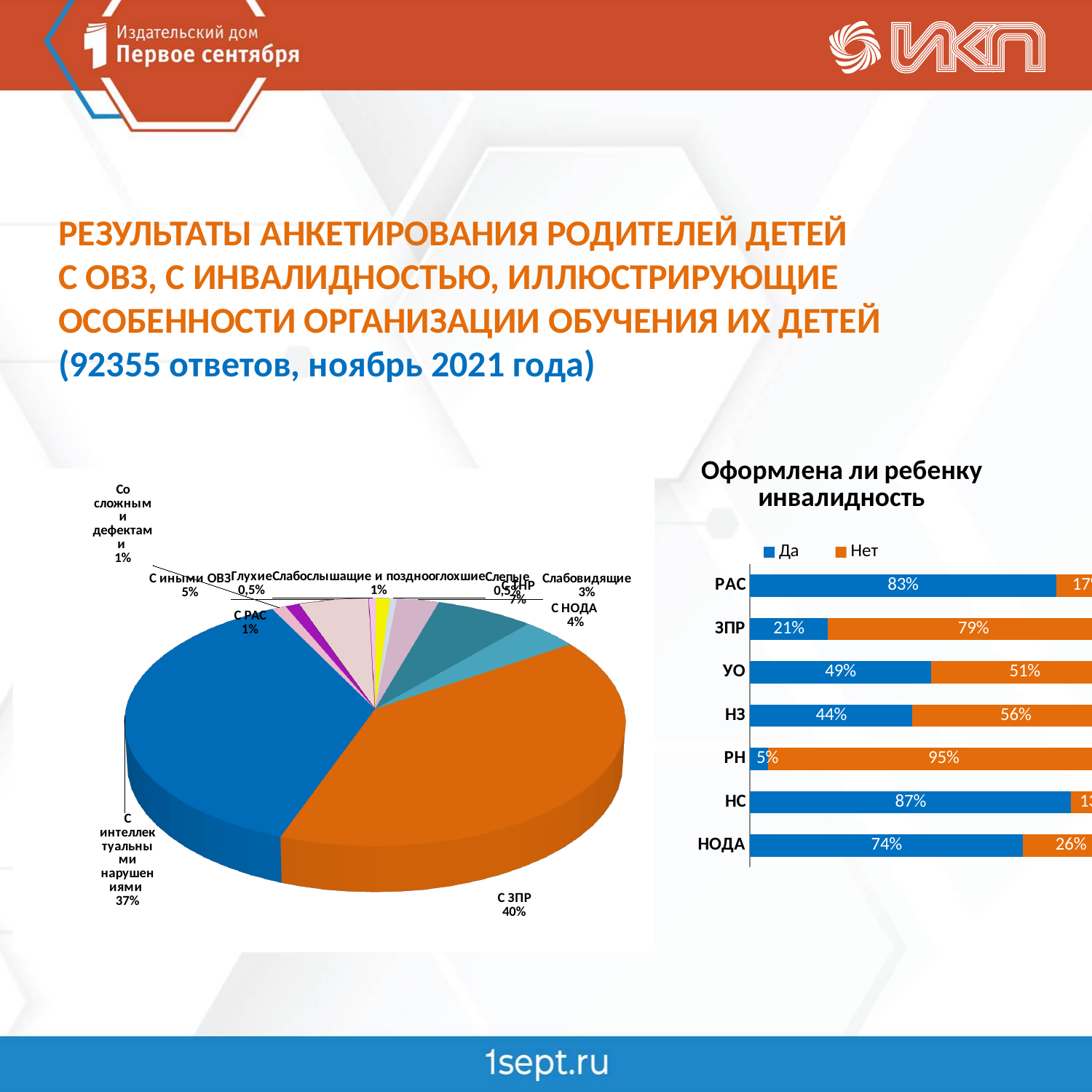
In the pie chart on the left, what share does the "С ЗПР" slice have? 40% In the pie chart on the left, which is larger: the "С НОДА" slice or the "Слабовидящие" slice? С НОДА In the chart titled "Оформлена ли ребенку инвалидность", what is the "Да" value for НОДА? 74% In the chart titled "Оформлена ли ребенку инвалидность", how many series does the legend list? 2 What kind of chart is the chart on the left of the slide? Pie chart In the chart titled "Оформлена ли ребенку инвалидность", what is the "Да" value for ЗПР? 21% In the chart titled "Оформлена ли ребенку инвалидность", which category has the highest "Да" value? НС In the chart titled "Оформлена ли ребенку инвалидность", which is larger: the "Да" value for УО or the "Да" value for НЗ? УО In the chart titled "Оформлена ли ребенку инвалидность", how many categories are shown? 7 In the chart titled "Оформлена ли ребенку инвалидность", which category has the lowest "Да" value? РН In the chart titled "Оформлена ли ребенку инвалидность", what is the difference between the "Нет" values for ЗПР and НОДА? 53% In the chart titled "Оформлена ли ребенку инвалидность", what is the "Нет" value for РН? 95%